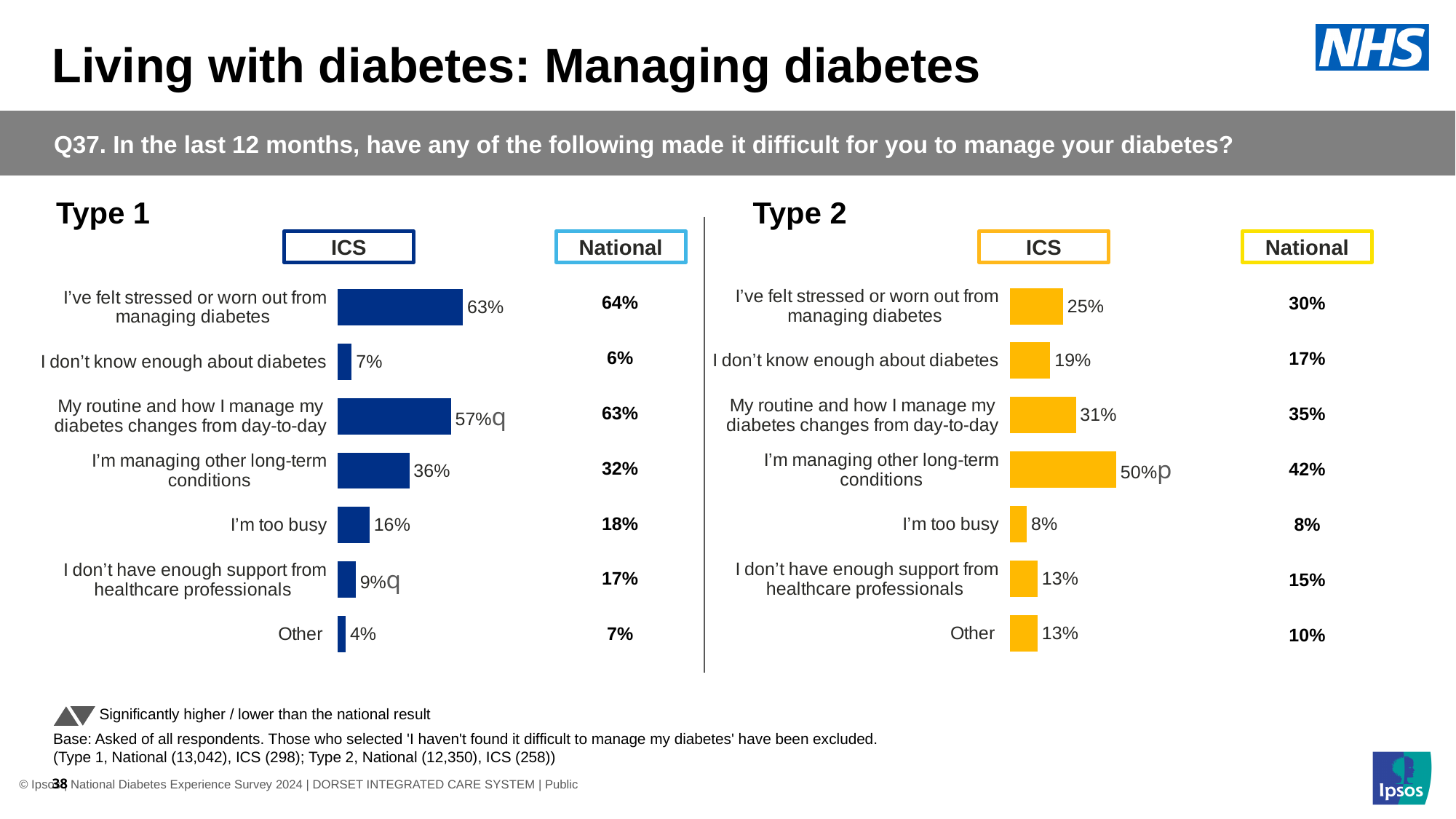
In the Type 2 chart, which category has the highest ICS value? I'm managing other long-term conditions In the Type 1 chart, which category has the highest ICS value? I've felt stressed or worn out from managing diabetes In the Type 1 chart, which category has the lowest ICS value? Other In the Type 1 chart, what is the National value for 'My routine and how I manage my diabetes changes from day-to-day'? 63% What kind of chart is used to show the ICS results for Type 1? Bar chart What colour are the ICS bars in the Type 2 chart? Yellow In the Type 1 chart, which is larger for 'I'm managing other long-term conditions': the ICS value or the National value? ICS How many categories are shown in the Type 2 chart? 7 In the Type 1 chart, what is the ICS value for 'I've felt stressed or worn out from managing diabetes'? 63% In the Type 2 chart, what is the ICS value for 'I'm managing other long-term conditions'? 50% In the Type 2 chart, what is the difference between the ICS and National values for 'I'm managing other long-term conditions'? 8 percentage points In the Type 2 chart, what is the National value for 'I don't know enough about diabetes'? 17%